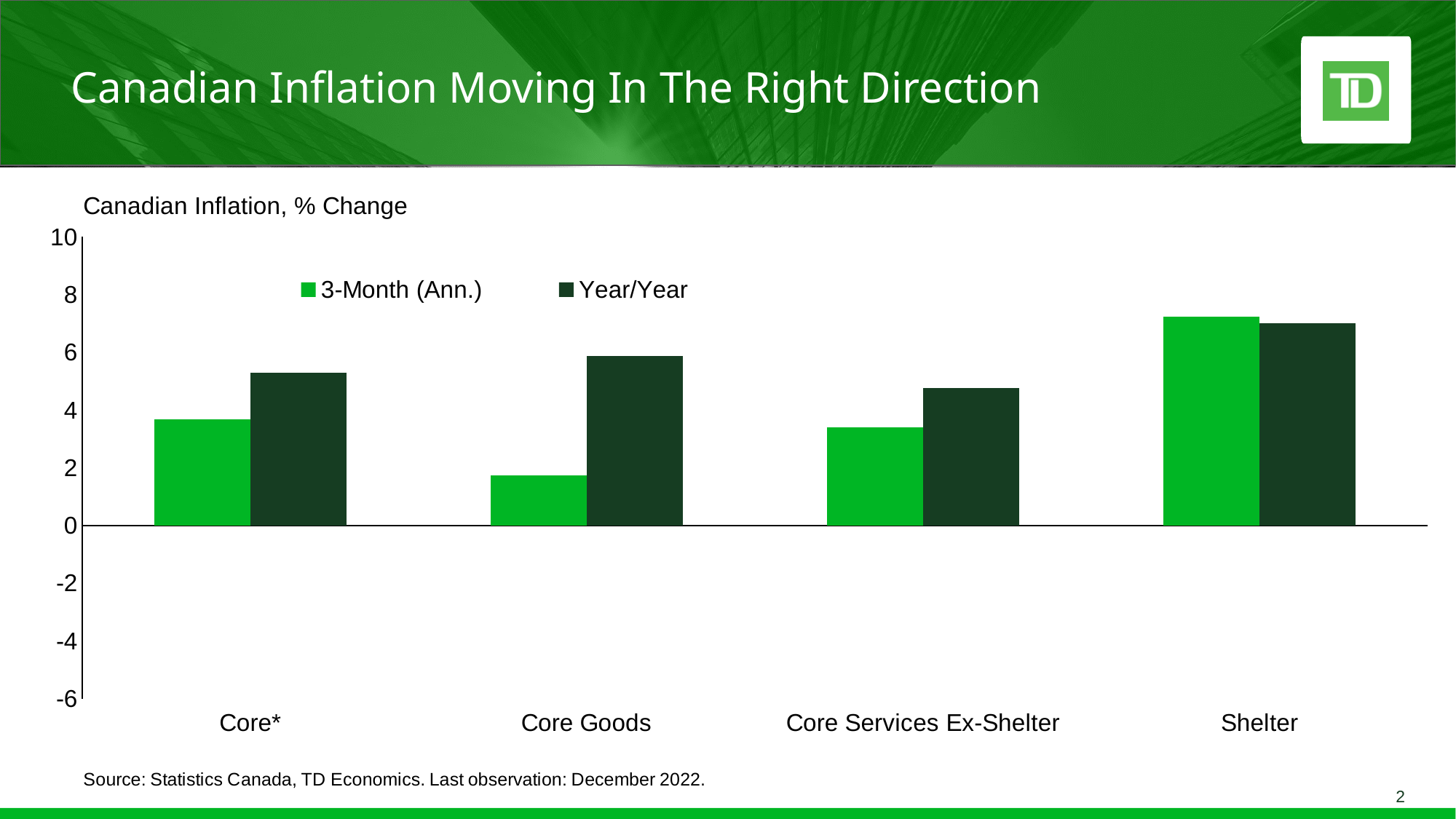
Is the 3-Month (Ann.) value for Shelter greater or less than 6? greater For Core Goods, which is larger: the 3-Month (Ann.) value or the Year/Year value? Year/Year Which category has the highest Year/Year value? Shelter Which category has the highest 3-Month (Ann.) value? Shelter Is the Year/Year value for Core* greater or less than 4? greater How many categories are shown on the x axis? 4 How many series does the legend list? 2 What is the title of the chart? Canadian Inflation, % Change Is the 3-Month (Ann.) value for Core Goods greater or less than 2? less Which category has the lowest 3-Month (Ann.) value? Core Goods What kind of chart is shown on the slide? bar chart For Core Services Ex-Shelter, which is larger: the 3-Month (Ann.) value or the Year/Year value? Year/Year